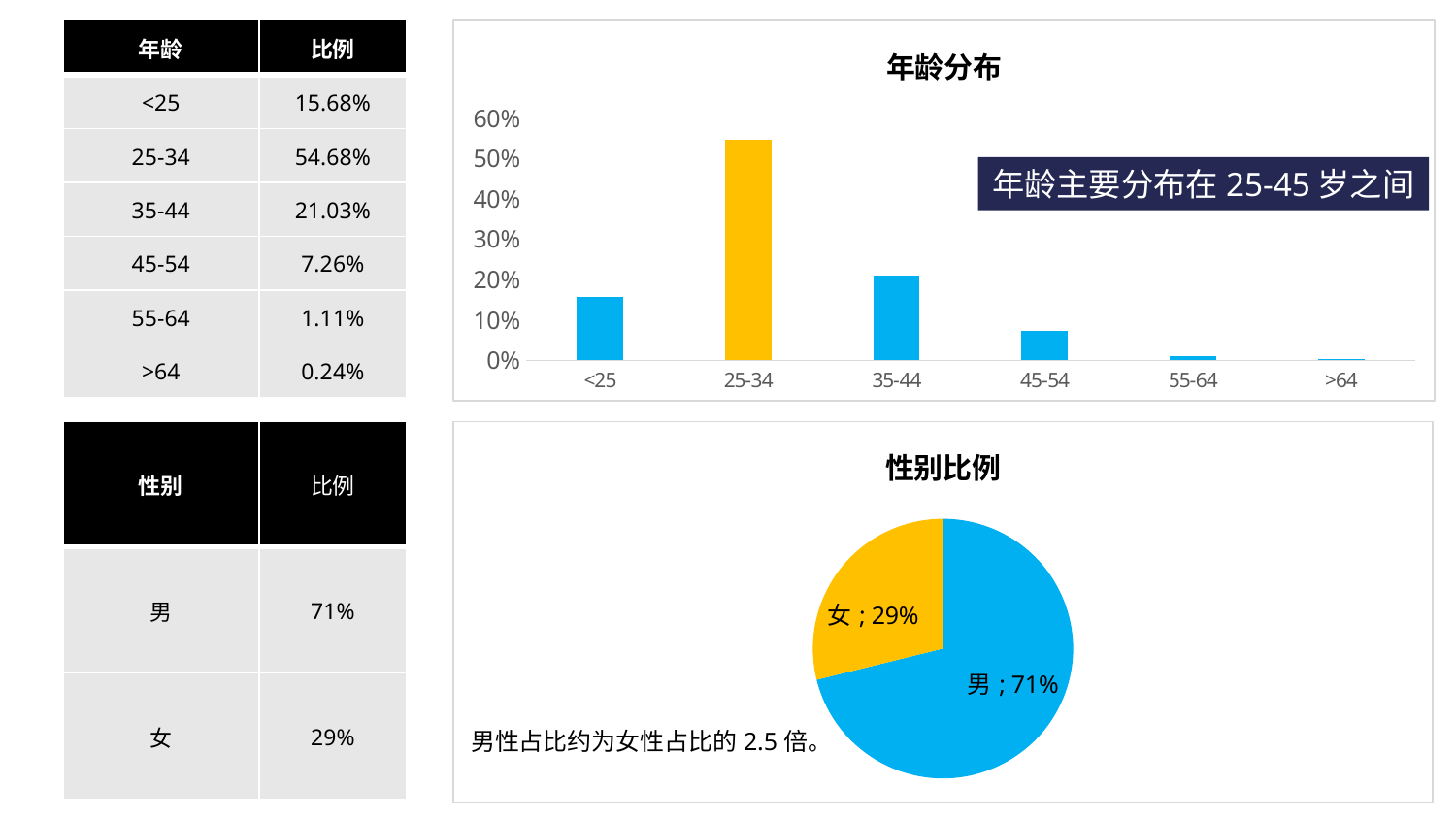
In the 性别比例 chart, what is the difference between the 男 and 女 shares? 42% How many age groups are shown in the 年龄分布 chart? 6 In the 年龄分布 chart, is the value for 25-34 greater or less than 50%? greater In the 年龄分布 chart, which age group has the highest value? 25-34 In the 年龄分布 chart, which age group has the lowest value? >64 In the 年龄分布 chart, which bar is highlighted in yellow? 25-34 What type of chart is the 性别比例 chart? pie chart In the 年龄分布 chart, is the value for 35-44 greater or less than 20%? greater In the 性别比例 chart, what share does 男 have? 71% In the 年龄分布 chart, which is larger, the value for <25 or the value for 35-44? 35-44 What type of chart is the 年龄分布 chart? bar chart In the 年龄分布 chart, is the value for 45-54 greater or less than 10%? less